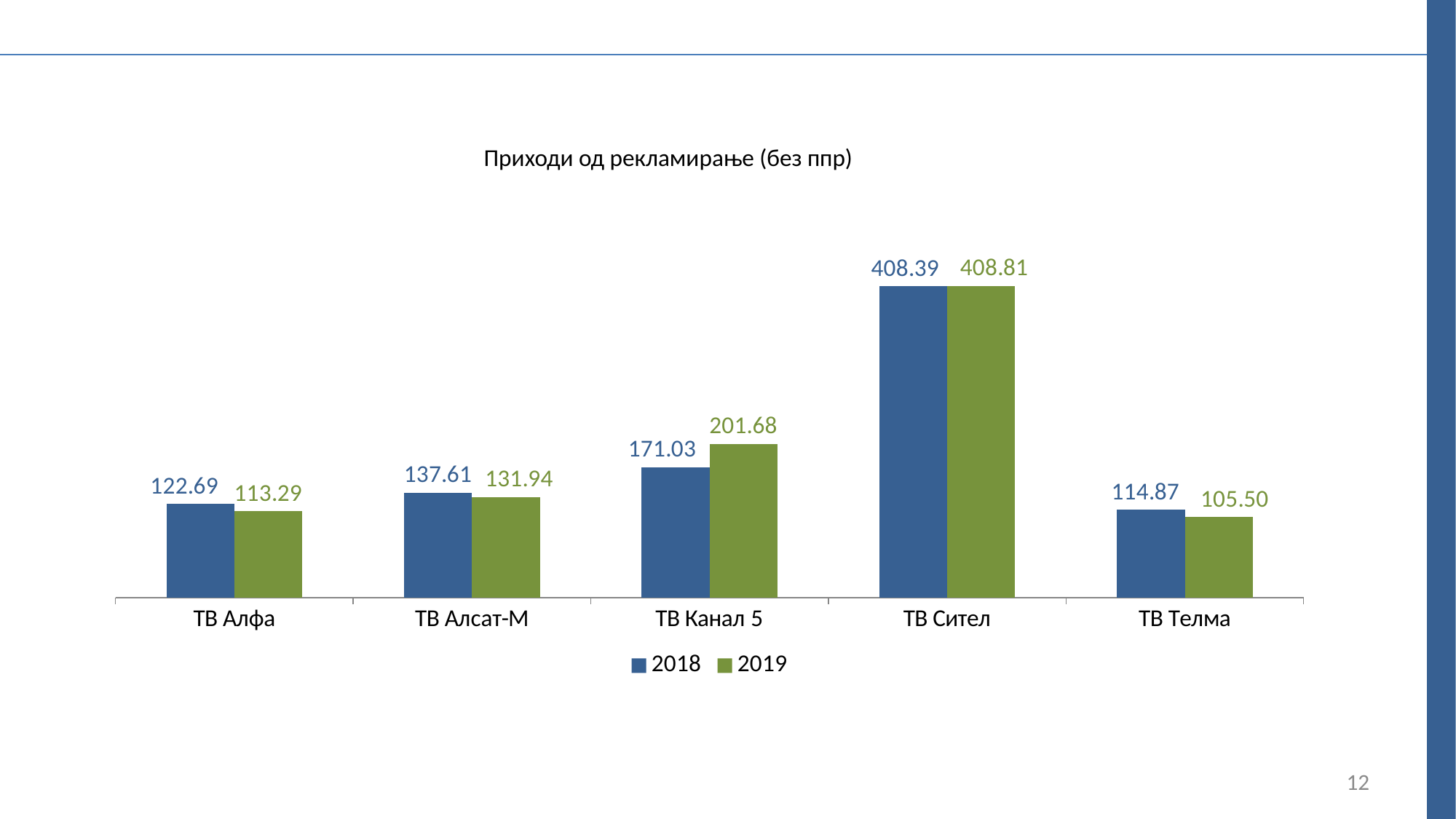
How many series does the legend list? 2 What is the 2019 value for ТВ Телма? 105.50 Which TV station has the highest 2018 value? ТВ Сител What is the difference between the 2018 and 2019 values for ТВ Алфа? 9.40 Which TV station has the lowest 2019 value? ТВ Телма For ТВ Алфа, which is larger: the 2018 value or the 2019 value? 2018 What is the title of the chart? Приходи од рекламирање (без ппр) What is the difference between the 2019 and 2018 values for ТВ Канал 5? 30.65 What is the 2019 value for ТВ Сител? 408.81 What type of chart is shown on the slide? bar chart How many TV stations (categories) are shown on the x axis? 5 What is the 2018 value for ТВ Канал 5? 171.03